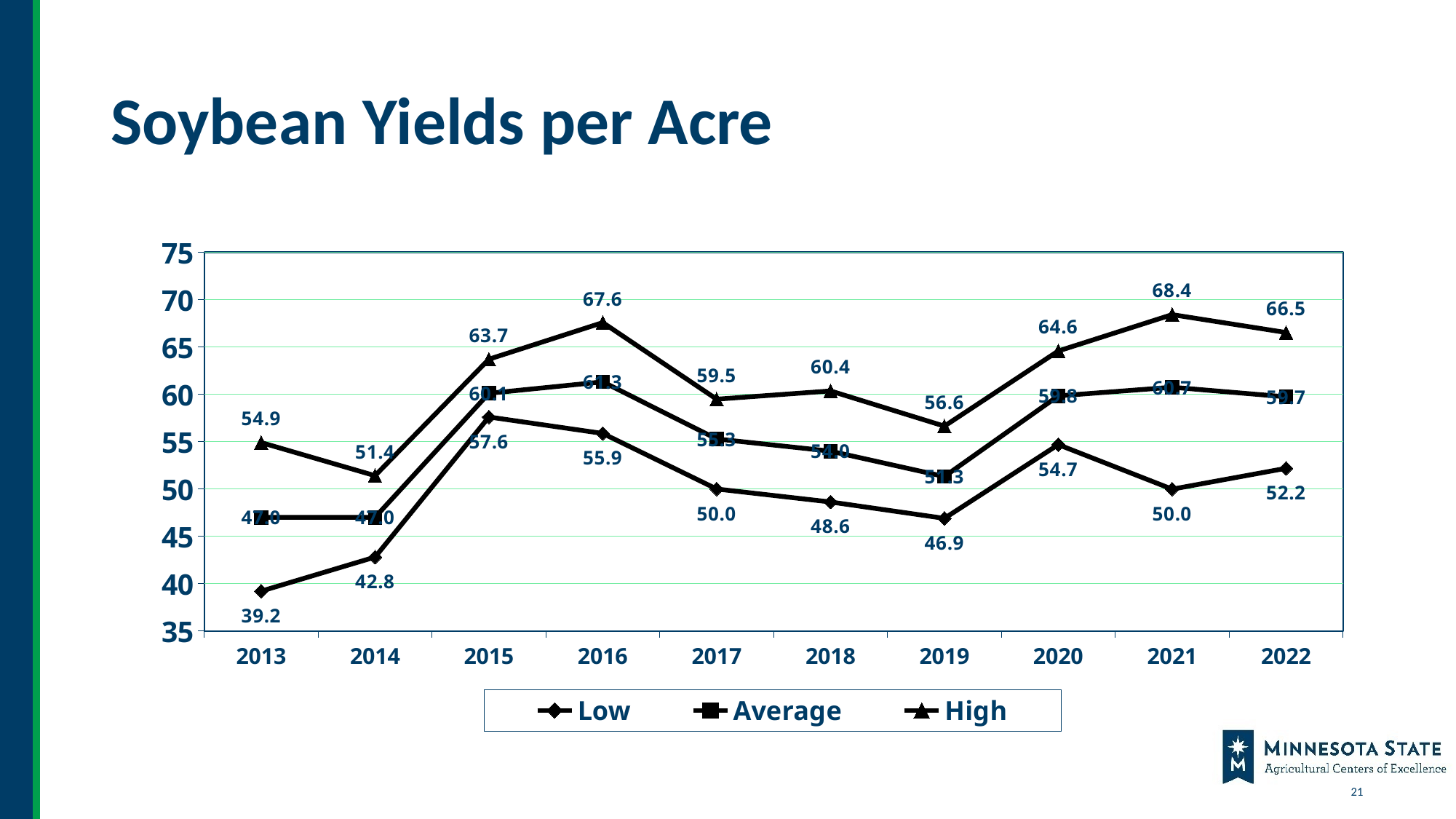
How many years are plotted along the x axis? 10 How many series does the legend list? 3 What is the difference between the High values for 2016 and 2015? 3.9 In which year is the High series at its highest? 2021 Does the Low series rise or fall from 2017 to 2019? Fall What is the High yield value for 2019? 56.6 What kind of chart is shown on the slide? Line chart What is the difference between the High and Low values in 2021? 18.4 What is the Low yield value for 2013? 39.2 What is the High yield value for 2021? 68.4 Which year has the larger Low value, 2015 or 2016? 2015 In which year is the Low series at its lowest? 2013